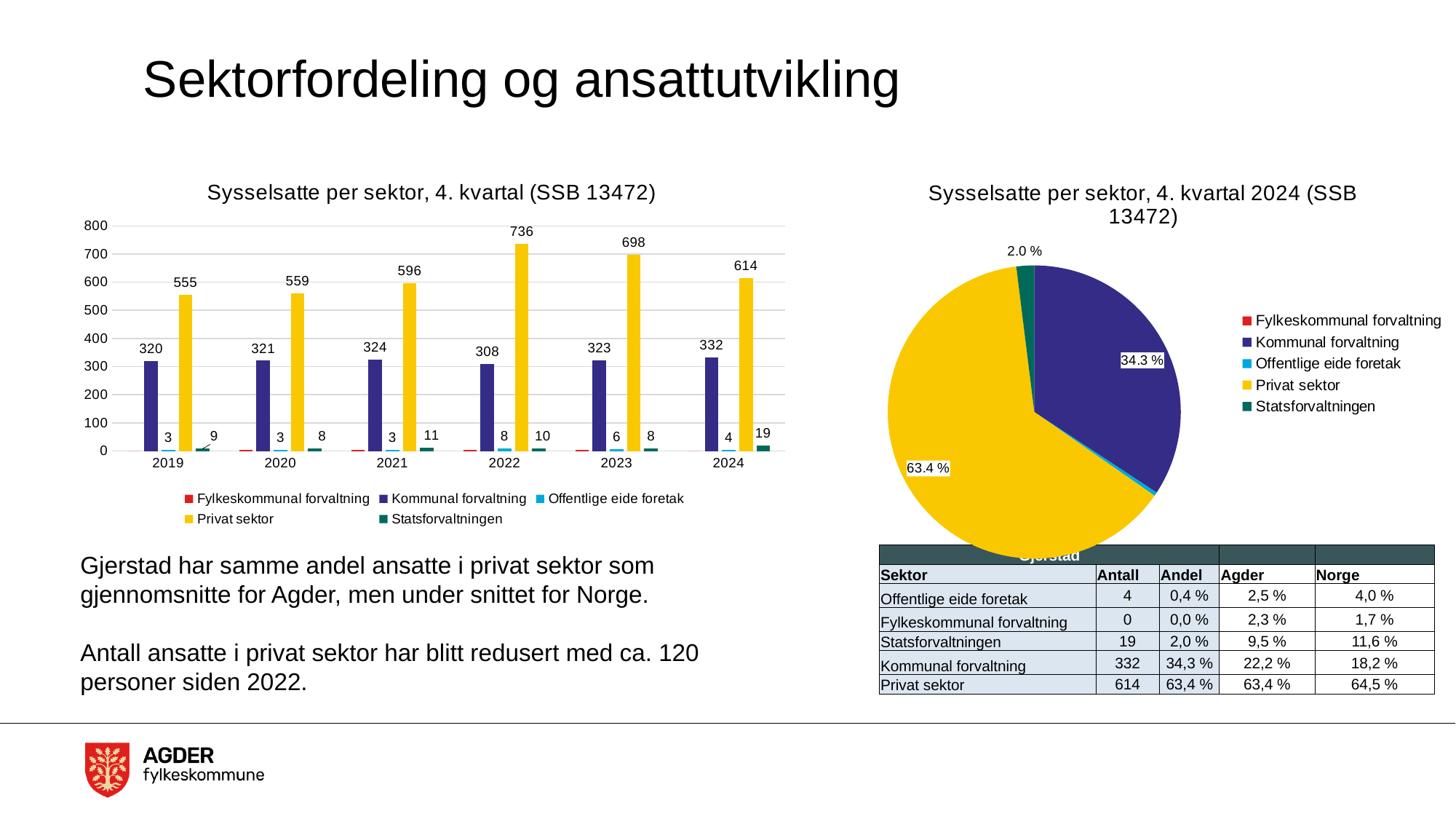
In the bar chart 'Sysselsatte per sektor, 4. kvartal (SSB 13472)', does Privat sektor rise or fall from 2022 to 2024? fall In the bar chart 'Sysselsatte per sektor, 4. kvartal (SSB 13472)', in which year is Privat sektor highest? 2022 In the bar chart 'Sysselsatte per sektor, 4. kvartal (SSB 13472)', how many years are shown on the x axis? 6 In the bar chart 'Sysselsatte per sektor, 4. kvartal (SSB 13472)', what is the value for Kommunal forvaltning in 2024? 332 What kind of chart is the chart on the right of the slide? pie chart In the bar chart 'Sysselsatte per sektor, 4. kvartal (SSB 13472)', in which year is Kommunal forvaltning lowest? 2022 In the bar chart 'Sysselsatte per sektor, 4. kvartal (SSB 13472)', what is the difference between Privat sektor in 2022 and in 2024? 122 In the bar chart 'Sysselsatte per sektor, 4. kvartal (SSB 13472)', how many series does the legend list? 5 In the bar chart 'Sysselsatte per sektor, 4. kvartal (SSB 13472)', what is the value for Privat sektor in 2022? 736 In the bar chart 'Sysselsatte per sektor, 4. kvartal (SSB 13472)', what is the value for Statsforvaltningen in 2021? 11 In the bar chart 'Sysselsatte per sektor, 4. kvartal (SSB 13472)', which is larger: Privat sektor in 2023 or Privat sektor in 2021? Privat sektor in 2023 In the pie chart 'Sysselsatte per sektor, 4. kvartal 2024 (SSB 13472)', what share does Privat sektor have? 63.4 %